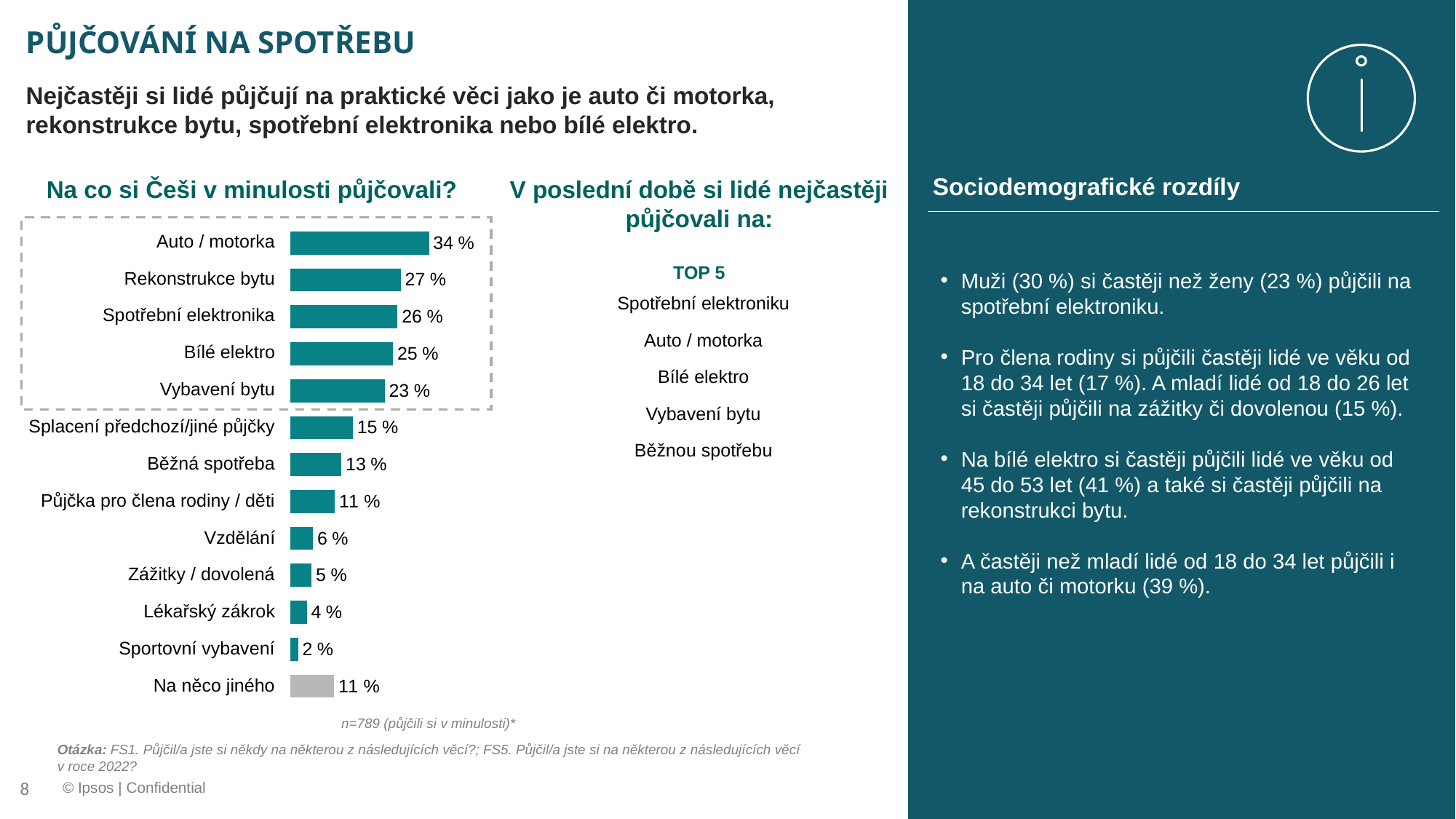
Which is larger, the value for Bílé elektro or the value for Běžná spotřeba? Bílé elektro What is the value for Na něco jiného? 11 % What is the value for Vybavení bytu? 23 % What kind of chart is shown on the slide? Bar chart What is the difference between the values for Auto / motorka and Rekonstrukce bytu? 7 % How many categories are shown in the bar chart? 13 What colour is the bar for Na něco jiného? Grey What is the value for Auto / motorka in the chart? 34 % What is the value for Lékařský zákrok? 4 % What is the value for Rekonstrukce bytu? 27 % Which category has the highest value in the chart? Auto / motorka Which category has the lowest value in the chart? Sportovní vybavení